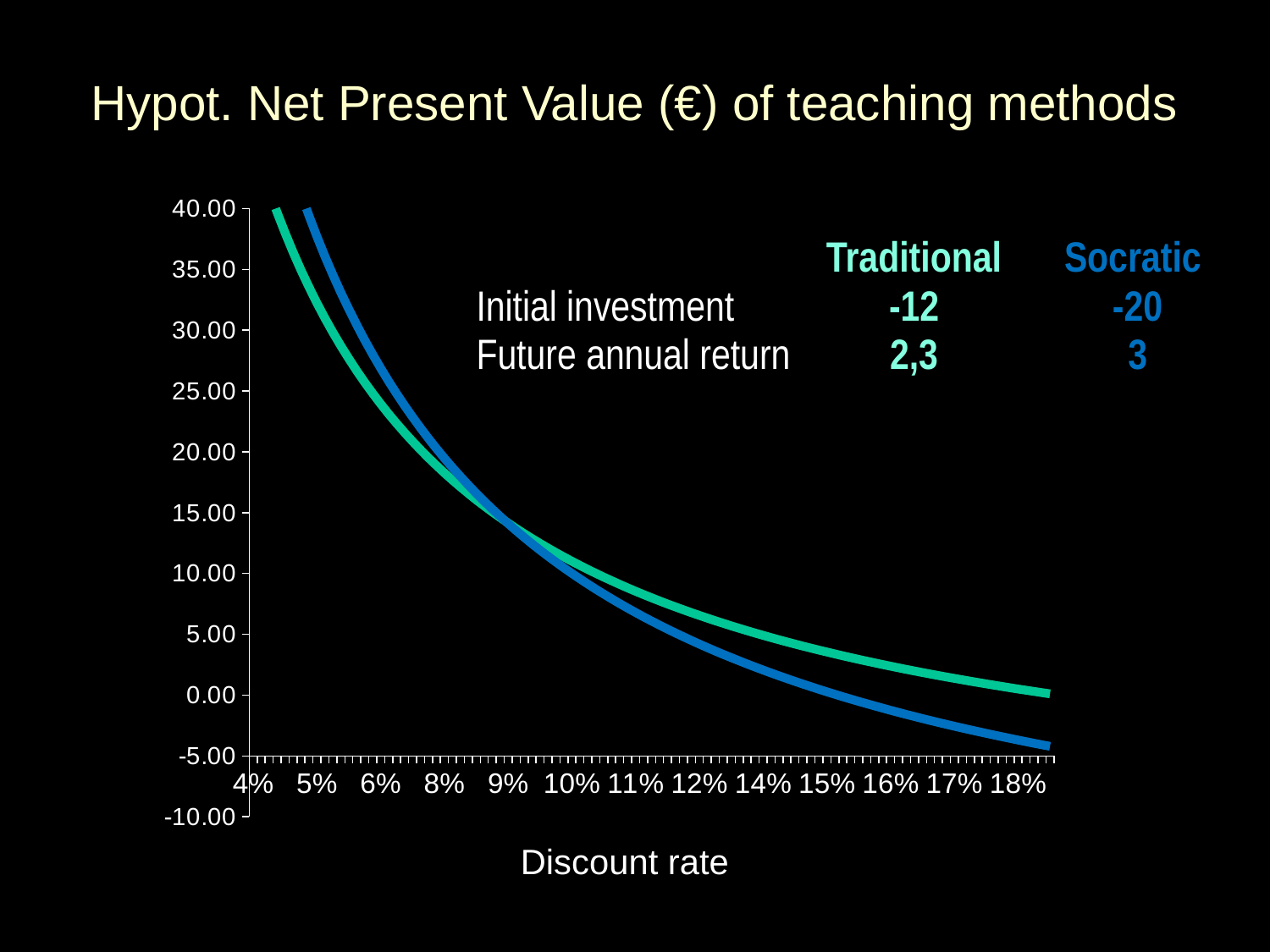
How many series does the chart show? 2 At a 5% discount rate, which method has the higher Net Present Value, Traditional or Socratic? Socratic Is the value for Socratic at a 15% discount rate greater or less than 5.00? less What is the initial investment shown for the Socratic method? -20 Is the value for Socratic at a 5% discount rate greater or less than 30.00? greater Do the Net Present Values rise or fall as the discount rate increases along the x axis? fall What is the title of the x axis? Discount rate Is the value for Traditional at a 10% discount rate greater or less than 5.00? greater At a 16% discount rate, which method has the higher Net Present Value, Traditional or Socratic? Traditional What kind of chart is shown on the slide? line chart